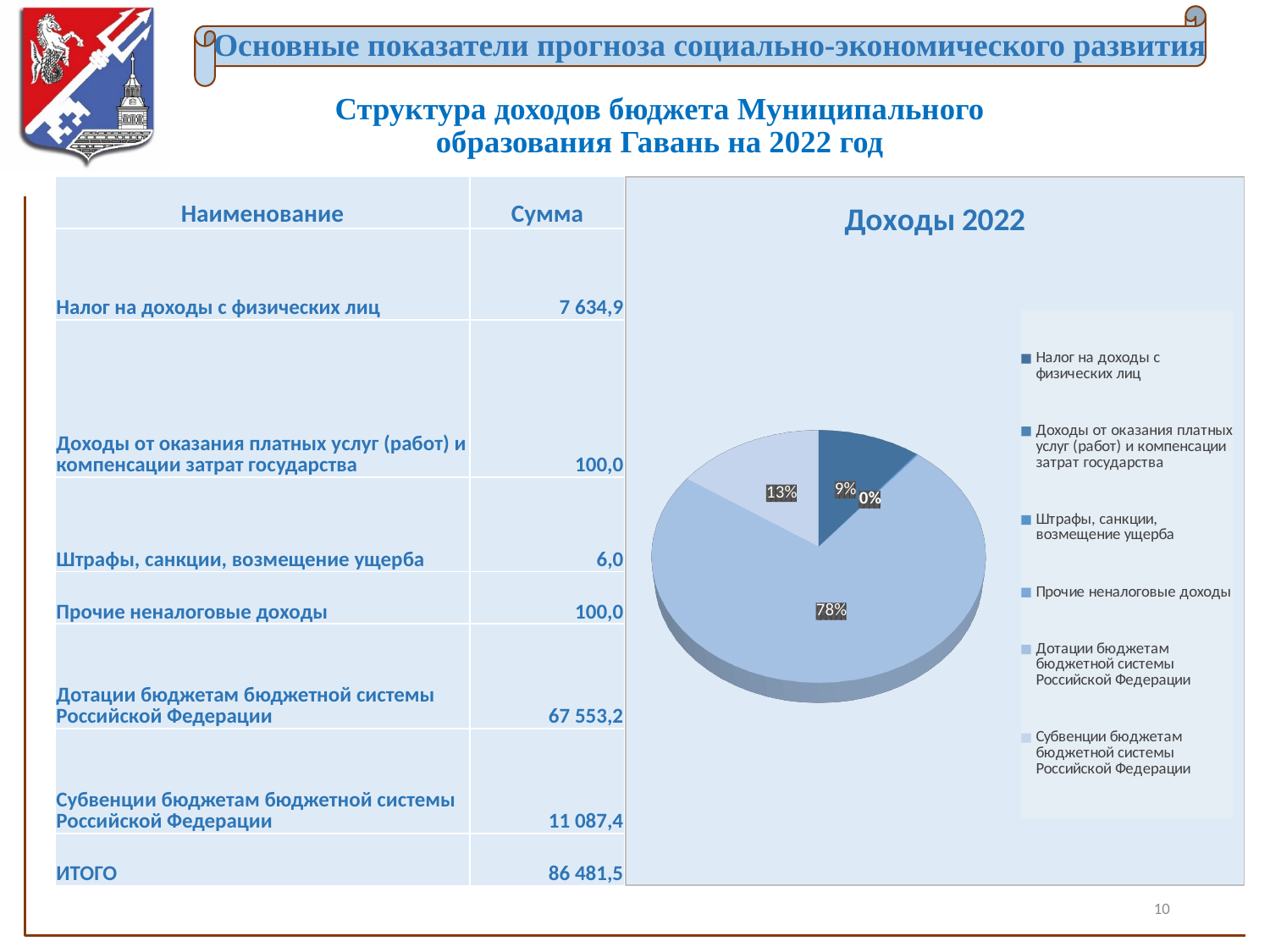
What kind of chart is shown on the slide? Pie chart How many entries does the chart legend list? 6 By how many percentage points does the Дотации slice exceed the Субвенции slice? 65 Which slice is larger: Субвенции бюджетам бюджетной системы Российской Федерации or Налог на доходы с физических лиц? Субвенции бюджетам бюджетной системы Российской Федерации What share of the pie is labelled for Субвенции бюджетам бюджетной системы Российской Федерации? 13% Which category is listed first in the chart legend? Налог на доходы с физических лиц Which category has the largest slice of the pie? Дотации бюджетам бюджетной системы Российской Федерации What share of the pie is labelled for Дотации бюджетам бюджетной системы Российской Федерации? 78% How many percentage data labels are printed on the pie? 4 What is the title of the chart? Доходы 2022 What share of the pie is labelled for Налог на доходы с физических лиц? 9% Is the share for Дотации бюджетам бюджетной системы Российской Федерации greater or less than 50%? greater